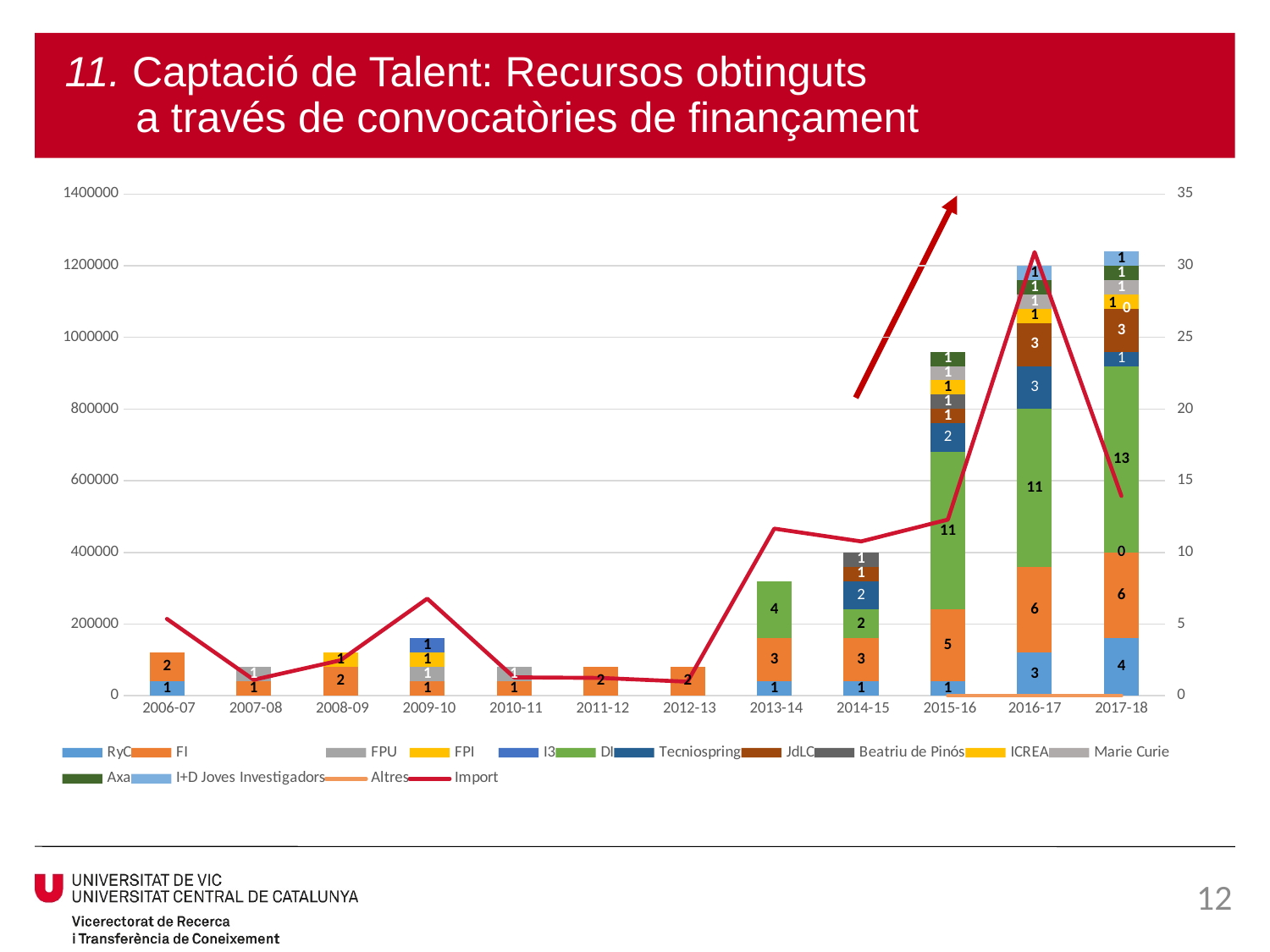
What kind of chart is shown on the slide? A stacked bar chart combined with a line What is the difference between the DI value for 2017-18 and the DI value for 2016-17? 2 Which is larger, the FI value for 2015-16 or the FI value for 2016-17? 2016-17 Does the Import line rise or fall from 2015-16 to 2016-17? Rise What is the total of the stacked bar for 2013-14? 8 What is the value of the FI segment for 2016-17? 6 How many academic years are shown along the x axis? 12 What is the value of the RyC segment for 2016-17? 3 What is the value of the DI segment for 2017-18? 13 How many series does the legend list? 15 Is the Import value for 2016-17 greater or less than 1000000? greater In which year does the Import line reach its highest point? 2016-17